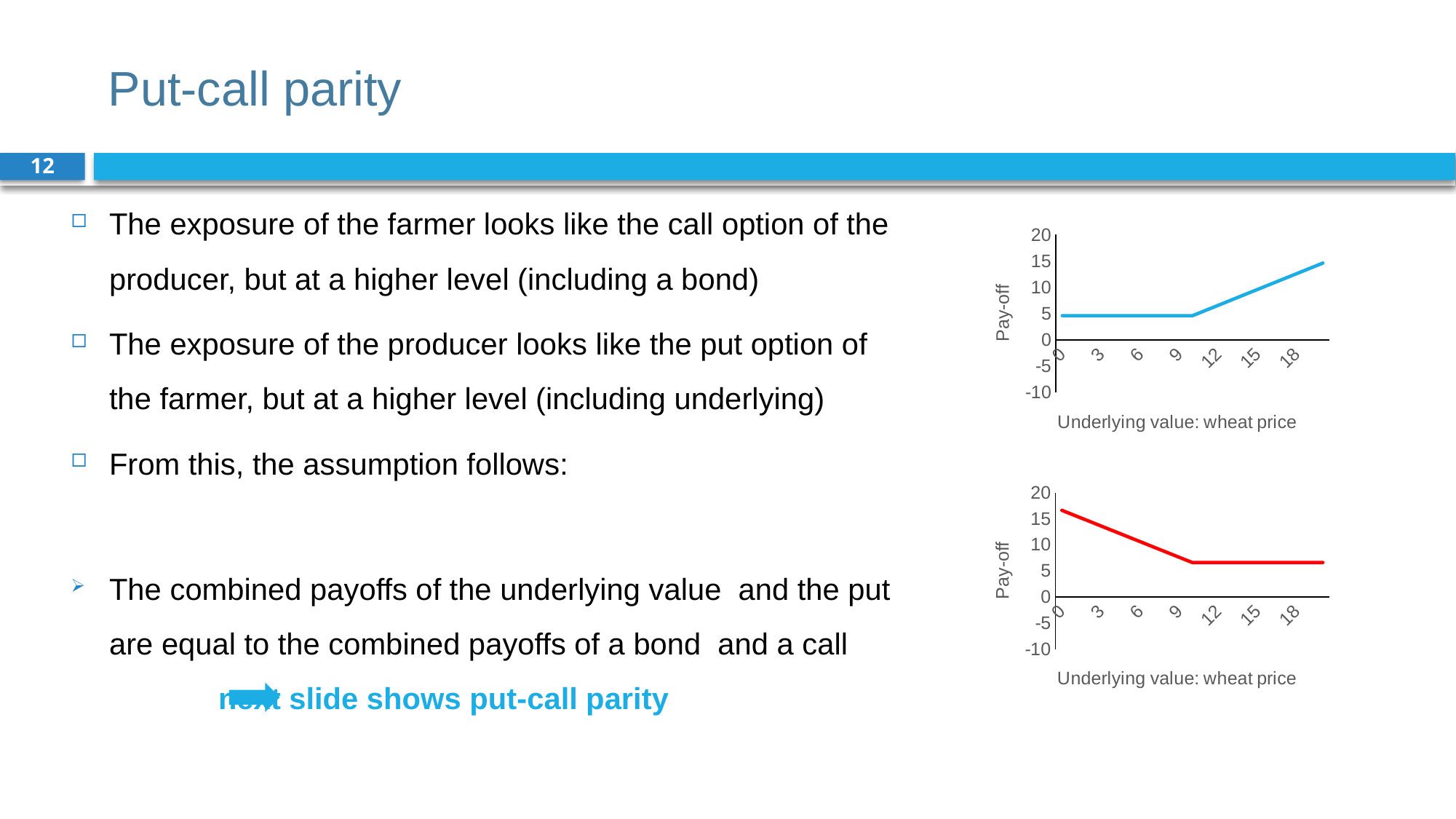
What is the highest value shown on the y-axis of the top chart? 20 In the bottom chart, is the pay-off at a wheat price of 15 greater or less than 10? less What kind of chart is the bottom chart on the slide? line chart In the top chart, does the pay-off rise or fall as the wheat price increases beyond 10? rise In the top chart, is the pay-off at a wheat price of 3 greater or less than 10? less In the top chart, is the pay-off at a wheat price of 18 greater or less than 10? greater What kind of chart is the top chart on the slide? line chart What is the y-axis label of the bottom chart? Pay-off In the bottom chart, does the pay-off rise or fall as the wheat price increases from 0 to 10? fall What is the x-axis label of the top chart? Underlying value: wheat price In the bottom chart, is the pay-off at a wheat price of 0 larger or smaller than the pay-off at a wheat price of 18? larger